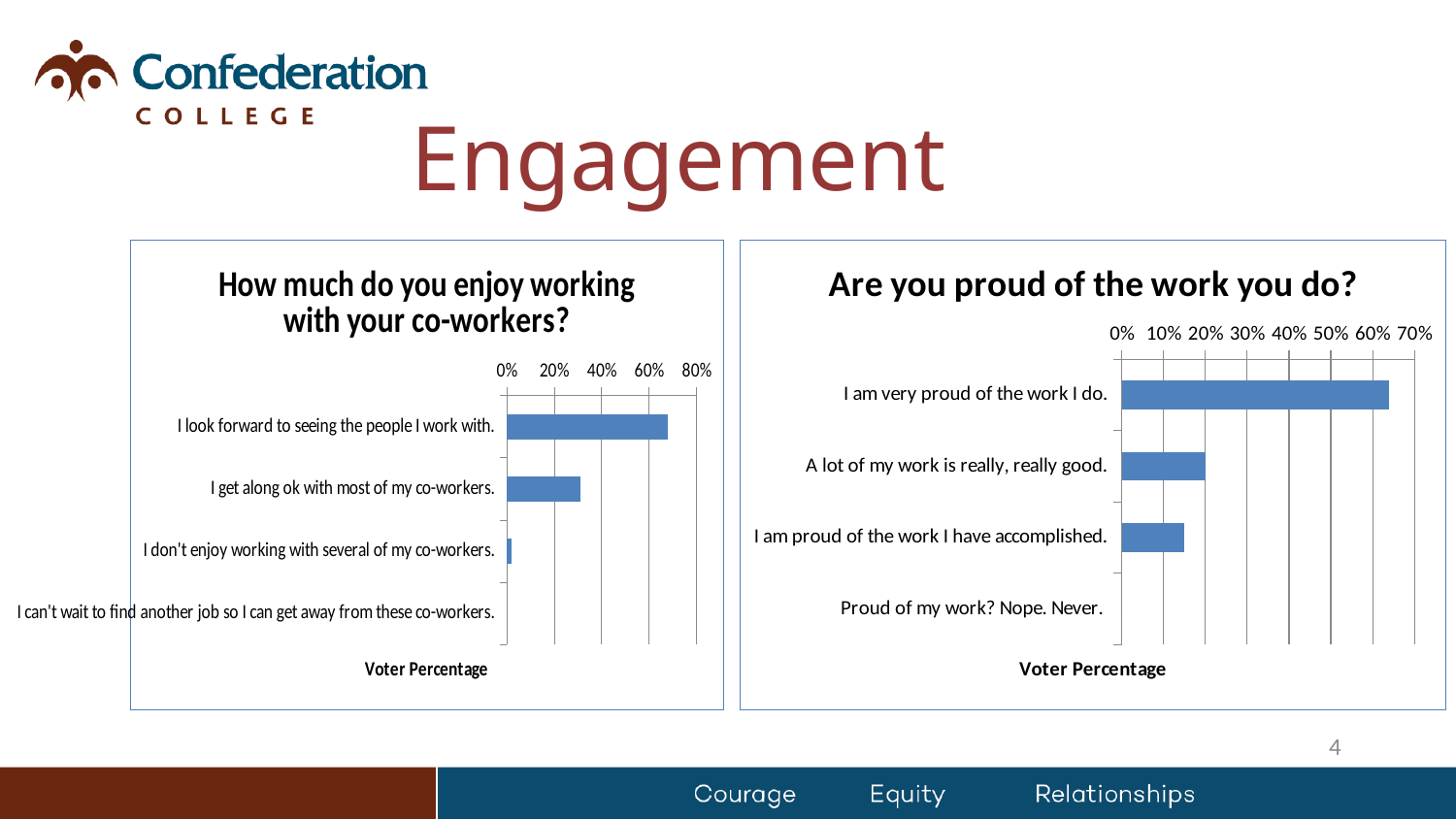
What kind of chart is the chart titled "Are you proud of the work you do?"? bar chart In the chart titled "How much do you enjoy working with your co-workers?", how many categories are shown? 4 In the chart titled "Are you proud of the work you do?", which is larger: the value for "A lot of my work is really, really good." or the value for "I am proud of the work I have accomplished."? A lot of my work is really, really good. In the chart titled "Are you proud of the work you do?", is the value for "I am very proud of the work I do." greater or less than 50%? greater In the chart titled "Are you proud of the work you do?", which category has the highest value? I am very proud of the work I do. In the chart titled "How much do you enjoy working with your co-workers?", is the value for "I get along ok with most of my co-workers." greater or less than 40%? less In the chart titled "How much do you enjoy working with your co-workers?", is the value for "I look forward to seeing the people I work with." greater or less than 60%? greater In the chart titled "How much do you enjoy working with your co-workers?", which category has the highest value? I look forward to seeing the people I work with. In the chart titled "How much do you enjoy working with your co-workers?", which category has the lowest value? I can't wait to find another job so I can get away from these co-workers. In the chart titled "Are you proud of the work you do?", which category has the lowest value? Proud of my work? Nope. Never. What is the axis title shown below the bars in the chart titled "Are you proud of the work you do?"? Voter Percentage